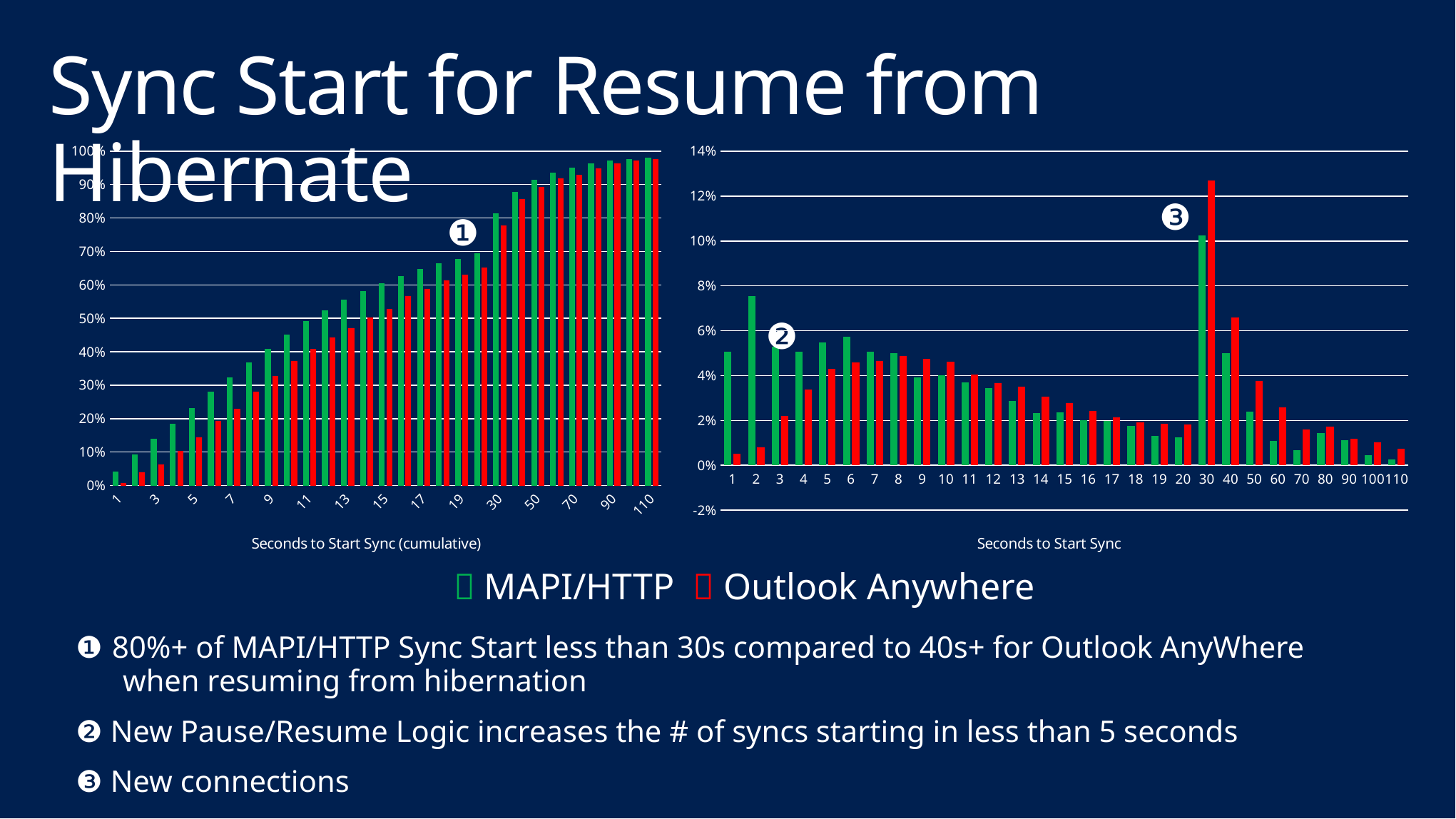
Which colour represents Outlook Anywhere in the legend? Red How many series does the shared legend list? 2 In the right chart (Seconds to Start Sync), which series has the larger value at 2: MAPI/HTTP or Outlook Anywhere? MAPI/HTTP In the right chart (Seconds to Start Sync), which series has the larger value at 40: MAPI/HTTP or Outlook Anywhere? Outlook Anywhere In the right chart (Seconds to Start Sync), is the MAPI/HTTP value at 2 greater or less than 6%? greater How many x-axis categories are labelled on the right chart (Seconds to Start Sync)? 29 In the right chart (Seconds to Start Sync), at which x-axis value is the MAPI/HTTP bar highest? 30 In the right chart (Seconds to Start Sync), is the Outlook Anywhere value at 30 greater or less than 12%? greater What kind of chart is the left chart, titled 'Seconds to Start Sync (cumulative)'? Bar chart In the left chart (Seconds to Start Sync (cumulative)), is the MAPI/HTTP value at 1 greater or less than 10%? less In the right chart (Seconds to Start Sync), at which x-axis value is the Outlook Anywhere bar highest? 30 In the left chart (Seconds to Start Sync (cumulative)), do the MAPI/HTTP values rise or fall along the x axis? Rise